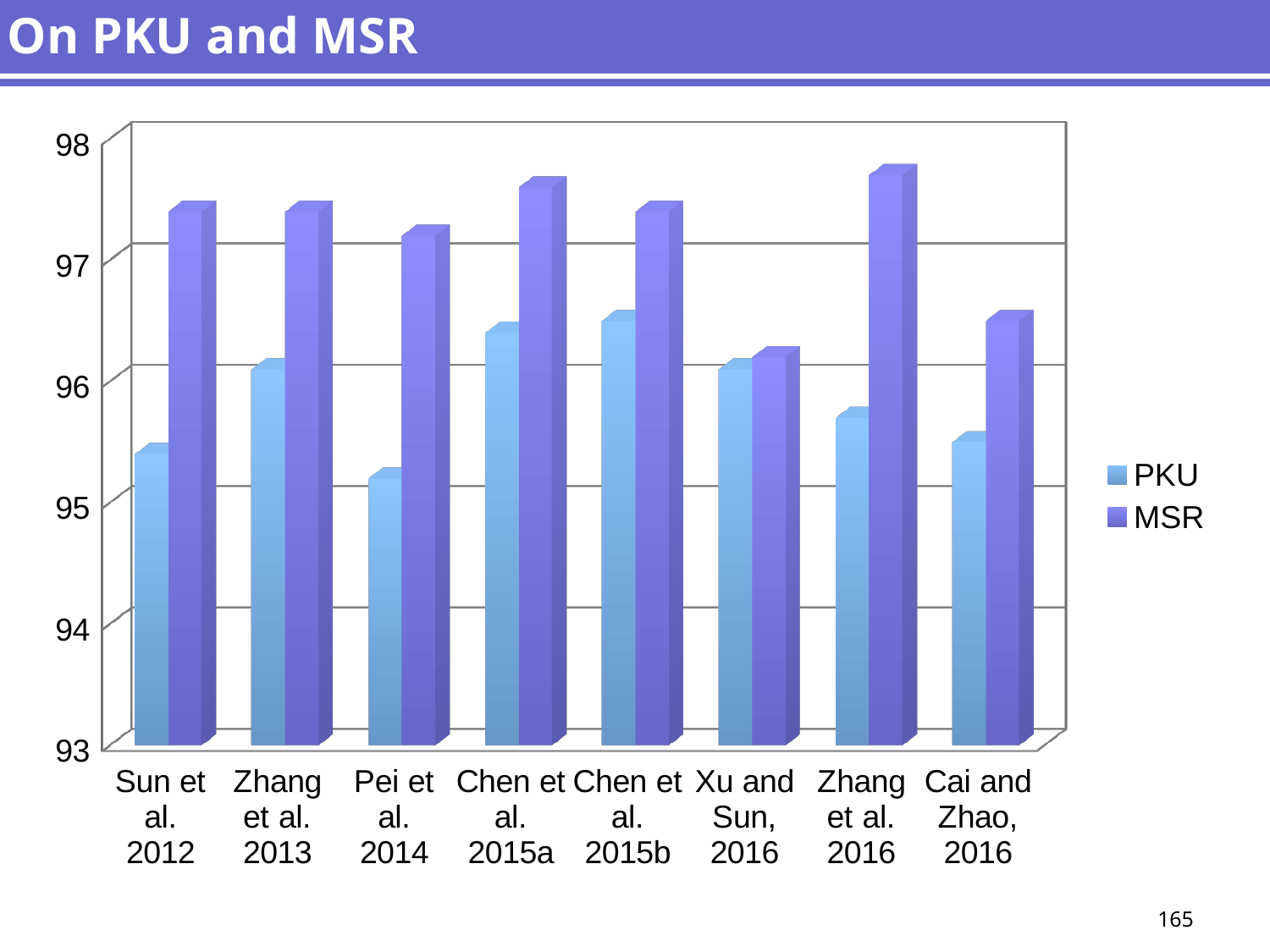
How many systems (categories) are shown along the x axis? 8 Is the PKU value for Chen et al. 2015b greater or less than 96? greater Is the MSR value for Chen et al. 2015a greater or less than 97? greater Which system has the lowest PKU value? Pei et al. 2014 Which system has the highest MSR value? Zhang et al. 2016 What are the two entries in the chart's legend? PKU and MSR How many series does the legend list? 2 What kind of chart is shown on the slide? bar chart Is the MSR value for Xu and Sun, 2016 greater or less than 97? less For Sun et al. 2012, which is larger, the PKU value or the MSR value? MSR Which system has the lowest MSR value? Xu and Sun, 2016